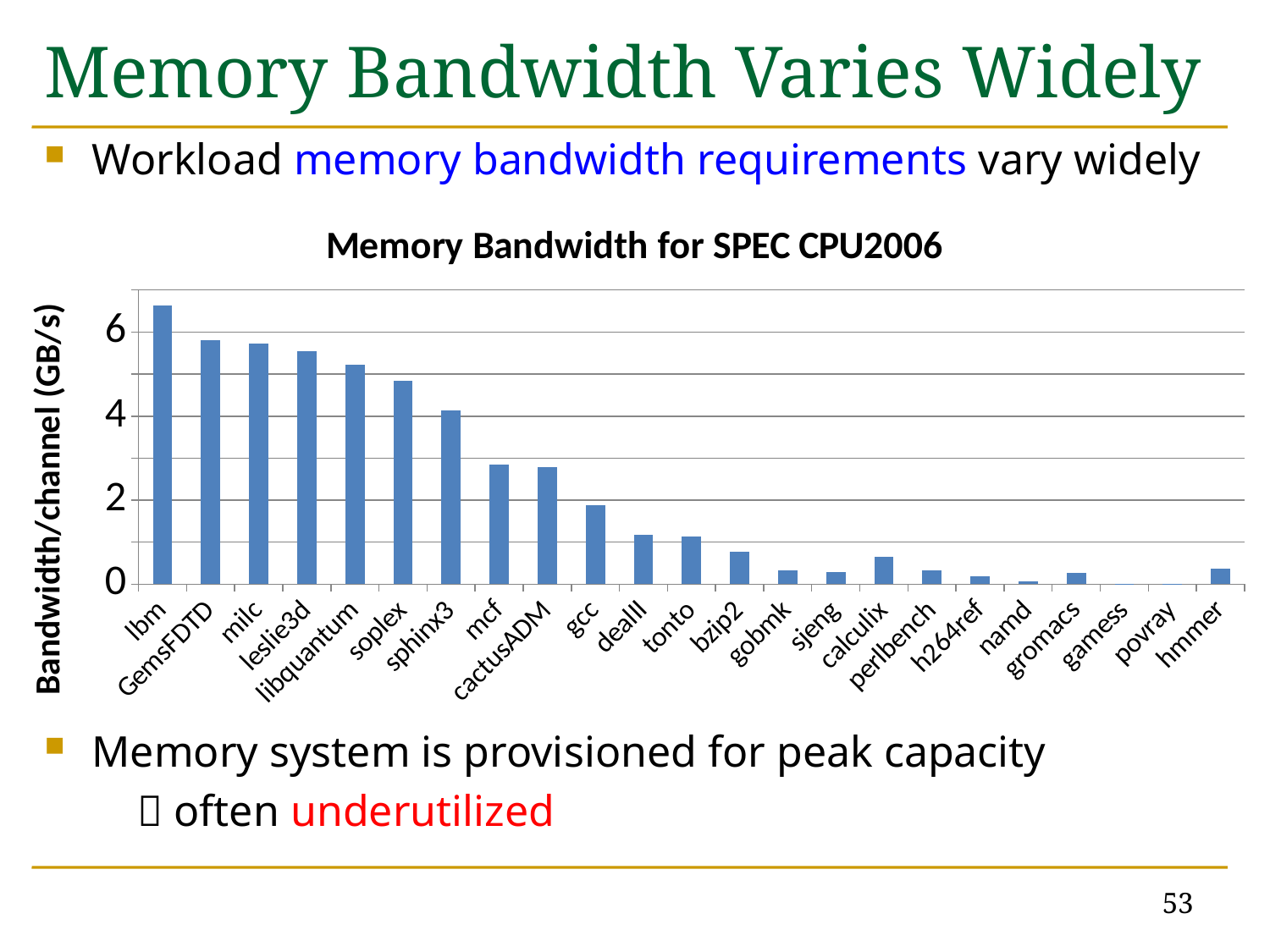
Do the bandwidth values generally rise or fall moving from left to right along the x axis? fall What is the title of the chart? Memory Bandwidth for SPEC CPU2006 Is the value for libquantum greater or less than 4? greater How many benchmarks are plotted along the x axis of the chart? 23 Which has a higher memory bandwidth, milc or gcc? milc Is the value for mcf greater or less than 4? less What type of chart is shown on the slide? bar chart What is the label of the vertical axis of the chart? Bandwidth/channel (GB/s) Which benchmark has the highest memory bandwidth in the chart? lbm Is the value for bzip2 greater or less than 2? less Which has a higher memory bandwidth, hmmer or soplex? soplex